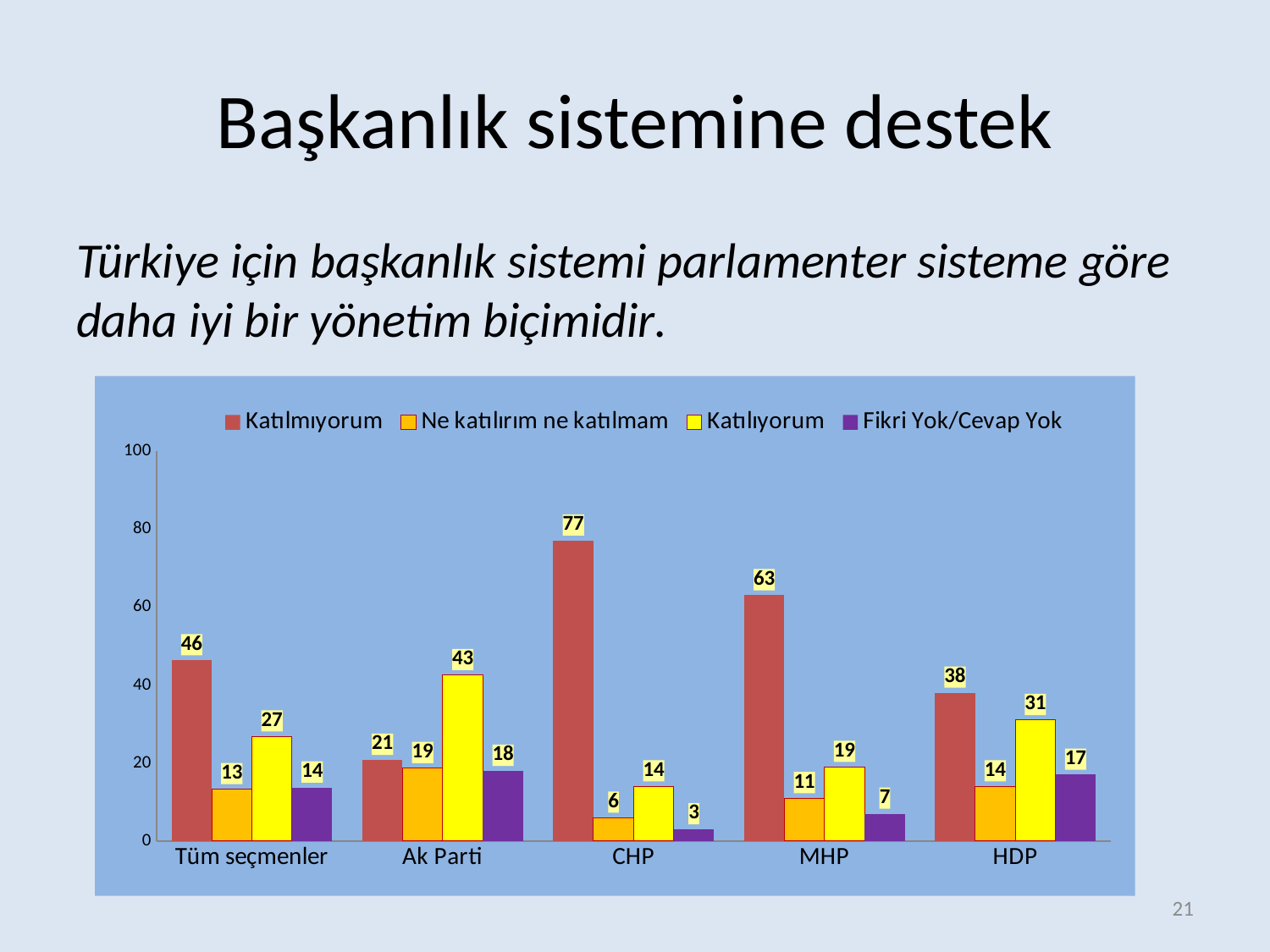
What is the value for Fikri Yok/Cevap Yok in the HDP category? 17 What kind of chart is shown on the slide? Bar chart Which category has the highest value for Katılmıyorum? CHP How many series does the legend list? 4 What is the value for Katılmıyorum in the CHP category? 77 Which colour represents the Katılıyorum series in the legend? Yellow What is the value for Ne katılırım ne katılmam in the CHP category? 6 What is the value for Katılıyorum in the Ak Parti category? 43 What is the difference between Katılmıyorum and Katılıyorum in the MHP category? 44 Which category has the lowest value for Fikri Yok/Cevap Yok? CHP Which is larger in the Tüm seçmenler category: Katılıyorum or Ne katılırım ne katılmam? Katılıyorum How many categories are shown on the x axis? 5